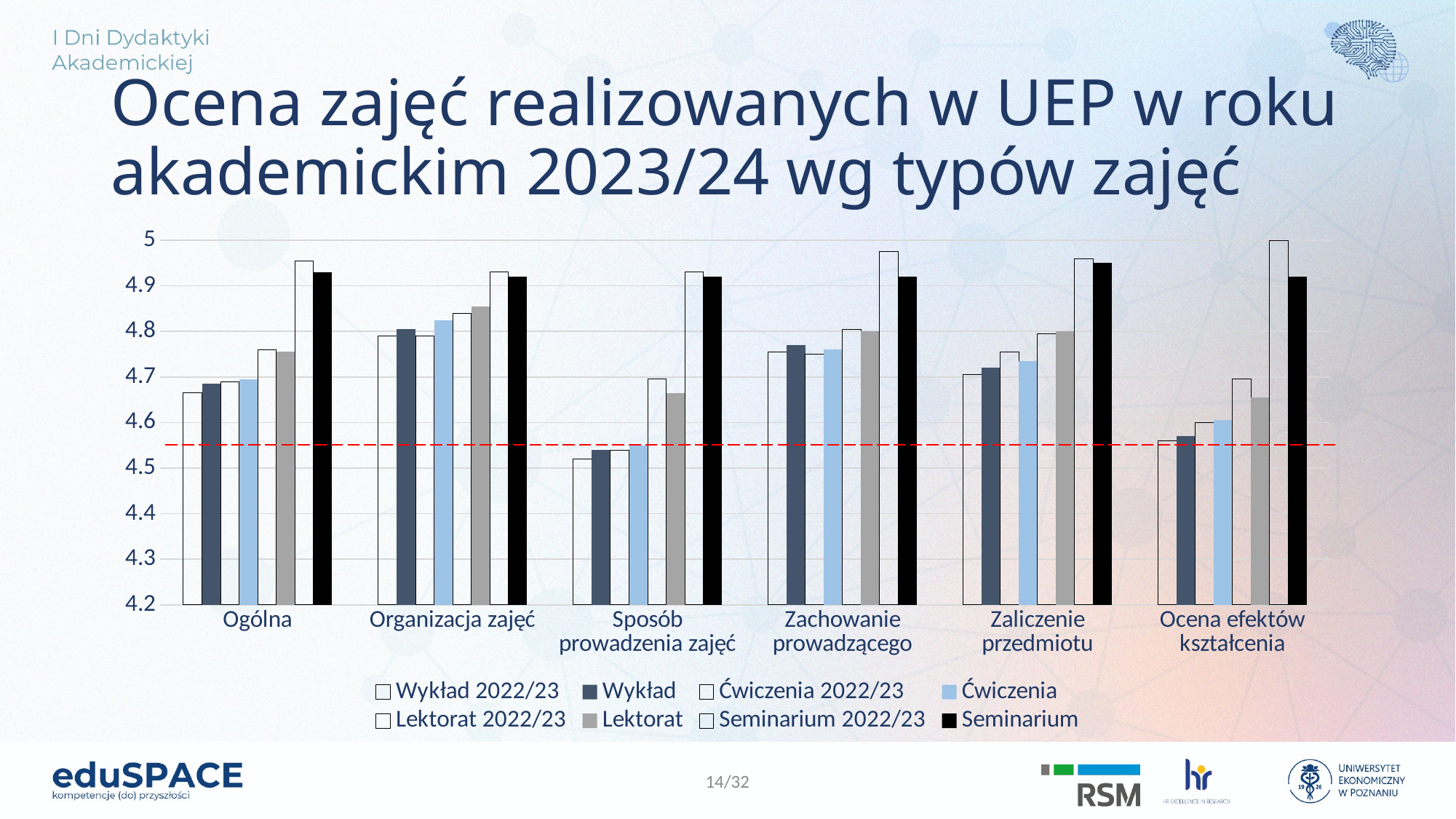
How many categories are shown along the x axis? 6 Is the value for Wykład in the category Sposób prowadzenia zajęć greater or less than 4.6? less What kind of chart is shown on the slide? bar chart In which category is the Lektorat value the highest? Organizacja zajęć Is the value for Seminarium 2022/23 in the category Ocena efektów kształcenia greater or less than 4.9? greater Is the value for Lektorat in the category Organizacja zajęć greater or less than 4.8? greater Which series has the highest value in the category Ocena efektów kształcenia? Seminarium 2022/23 In which category is the Ćwiczenia value the lowest? Sposób prowadzenia zajęć How many series does the legend list? 8 Which series is drawn in black in the legend? Seminarium In the category Ogólna, which is larger: the value for Seminarium or the value for Wykład? Seminarium